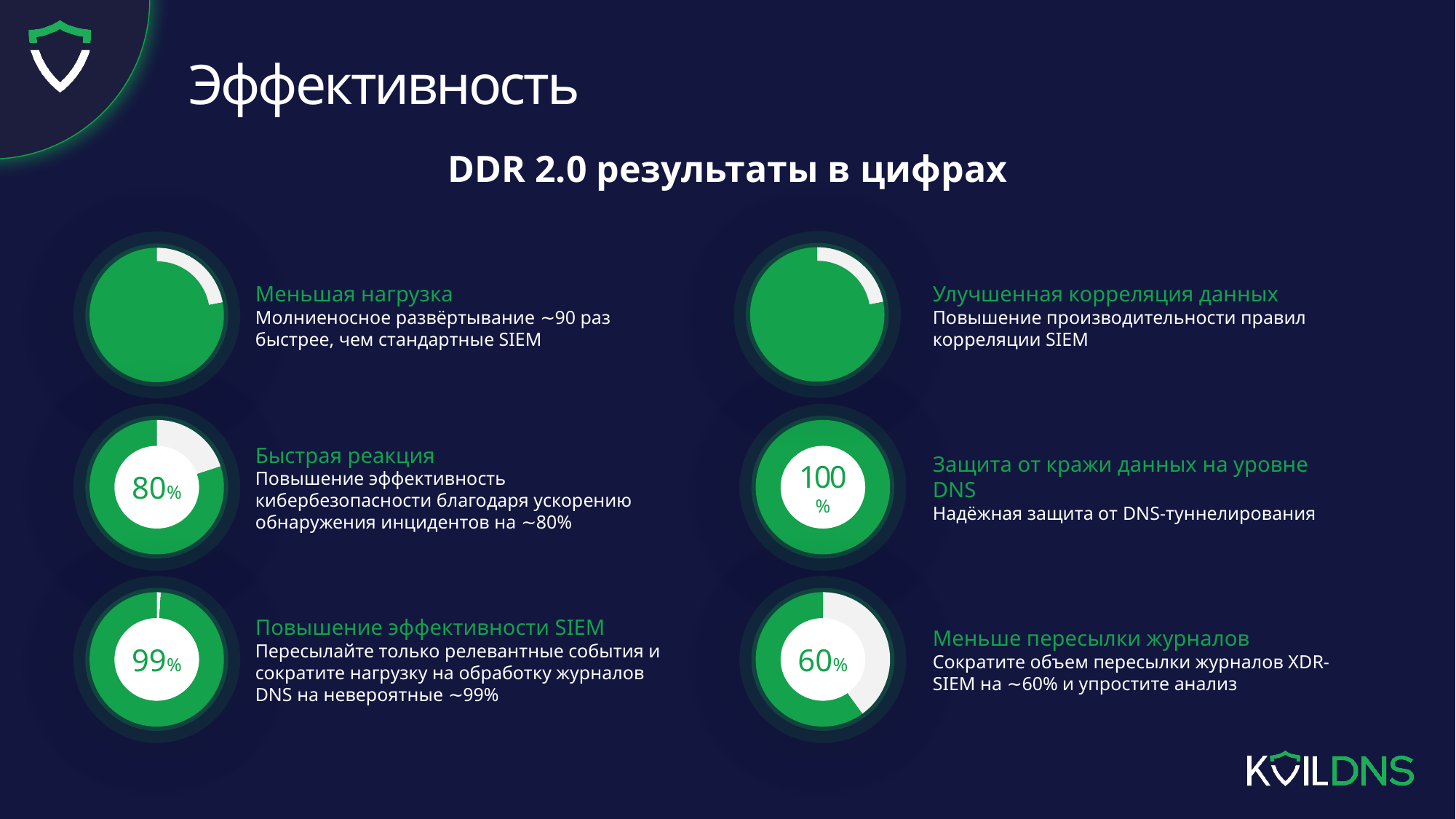
What kind of chart is used to display the figures on this slide? Donut chart What value is shown in the donut chart labelled "Меньше пересылки журналов"? 60% How many circular (donut) charts are shown on the slide? 6 What is the difference between the value in the "Повышение эффективности SIEM" chart and the value in the "Меньше пересылки журналов" chart? 39 percentage points Among the donut charts with printed values, which one shows the lowest value? Меньше пересылки журналов (60%) Which chart shows a larger value: "Быстрая реакция" or "Меньше пересылки журналов"? Быстрая реакция What is the difference between the value in the "Защита от кражи данных на уровне DNS" chart and the value in the "Быстрая реакция" chart? 20 percentage points What value is shown in the donut chart labelled "Быстрая реакция"? 80% What value is shown in the donut chart labelled "Защита от кражи данных на уровне DNS"? 100% What value is shown in the donut chart labelled "Повышение эффективности SIEM"? 99% Among the donut charts with printed values, which one shows the highest value? Защита от кражи данных на уровне DNS (100%) What is the heading above the group of charts on the slide? DDR 2.0 результаты в цифрах